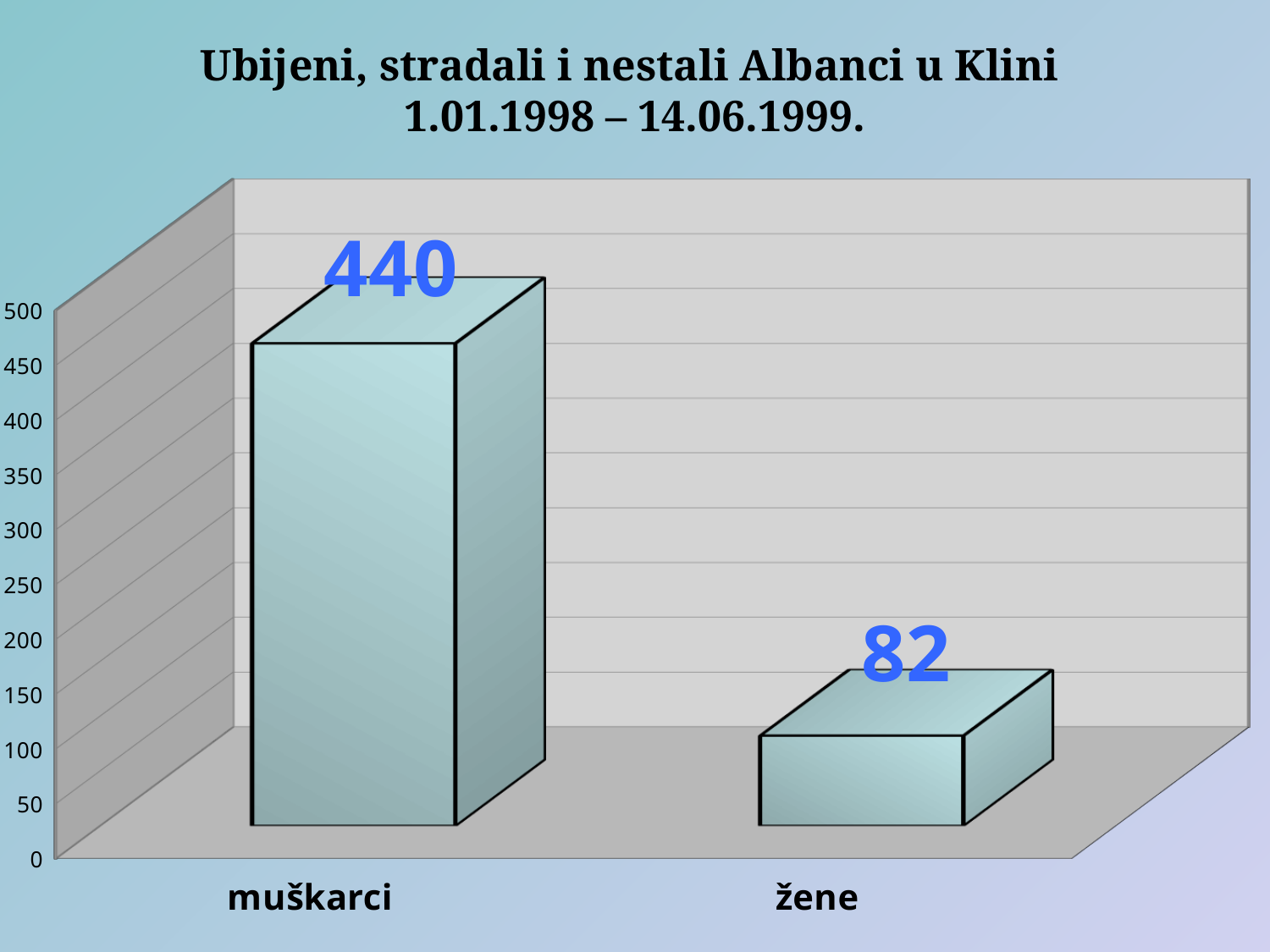
Which category has the highest value? muškarci What is the total of the two values shown on the chart? 522 Which is larger, the value for muškarci or the value for žene? muškarci What is the difference between the values for muškarci and žene? 358 What kind of chart is shown on the slide? bar chart What is the title of the chart? Ubijeni, stradali i nestali Albanci u Klini 1.01.1998 – 14.06.1999. What is the value for muškarci? 440 Which category has the lowest value? žene What is the value for žene? 82 How many categories are shown on the chart? 2 Is the value for muškarci greater or less than 400? greater Is the value for žene greater or less than 100? less